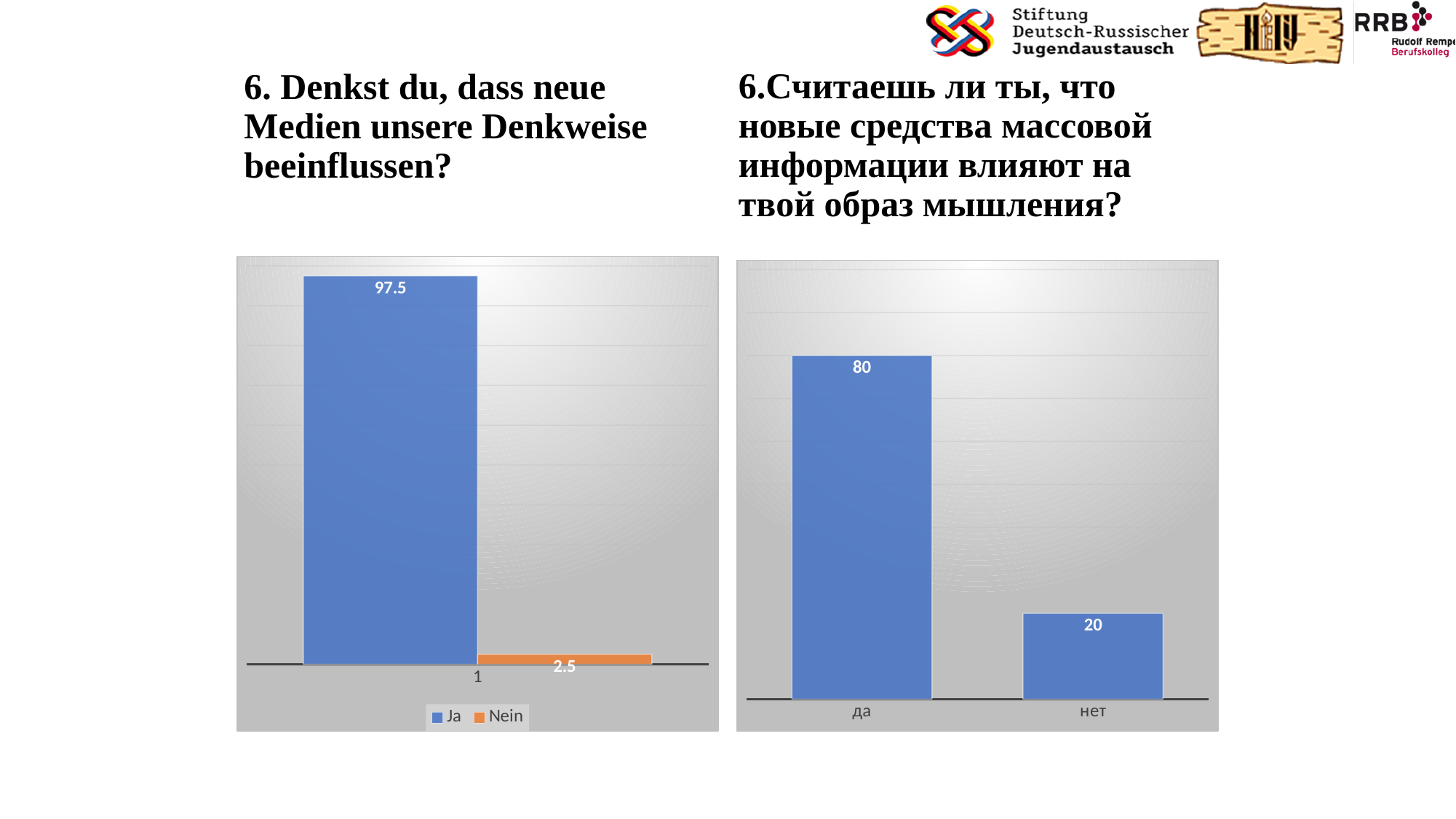
In the left chart, how many series does the legend list? 2 In the left chart, what is the value for Nein? 2.5 In the right chart, what is the value for нет? 20 In the left chart, what is the value for Ja? 97.5 In the right chart, what is the value for да? 80 In the right chart, how many categories are shown on the x axis? 2 In the right chart, which category has the lowest value? нет What kind of chart is the right chart? Bar chart In the left chart, what colour is the bar for Nein? Orange In the right chart, what is the difference between the values for да and нет? 60 In the left chart, which series has the higher value, Ja or Nein? Ja In the left chart, what is the difference between the values for Ja and Nein? 95